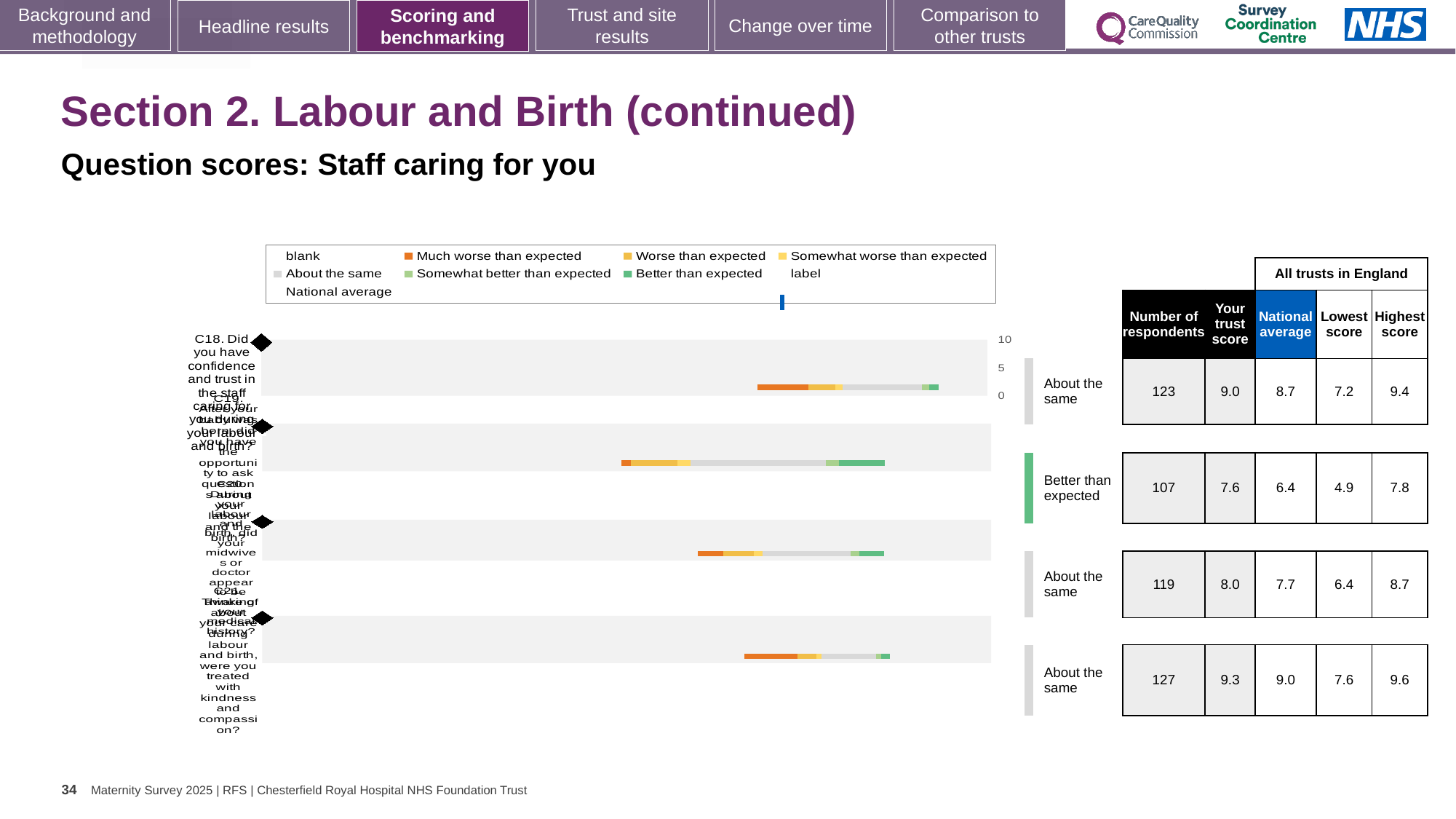
What kind of chart is shown on the slide? bar chart How many questions (rows) are plotted in the chart? 4 In the table, what is the national average for the first row (C18, confidence and trust in the staff)? 8.7 For the 'Better than expected' row, what is the difference between 'Your trust score' and the national average? 1.2 In the table, what is the number of respondents for the row rated 'Better than expected'? 107 Which row has the lowest 'Your trust score' in the table? The 'Better than expected' row (C19), 7.6 In the table, what is the lowest score for the third row (C20)? 6.4 In the table, what is 'Your trust score' for the row rated 'Better than expected'? 7.6 Which row has the highest 'Your trust score' in the table? The last row (C21), 9.3 In the table, what is the highest score for the last row (C21, treated with kindness and compassion)? 9.6 For the first row (C18), which is larger: 'Your trust score' or the national average? Your trust score (9.0) What is the subtitle describing the chart on this slide? Question scores: Staff caring for you